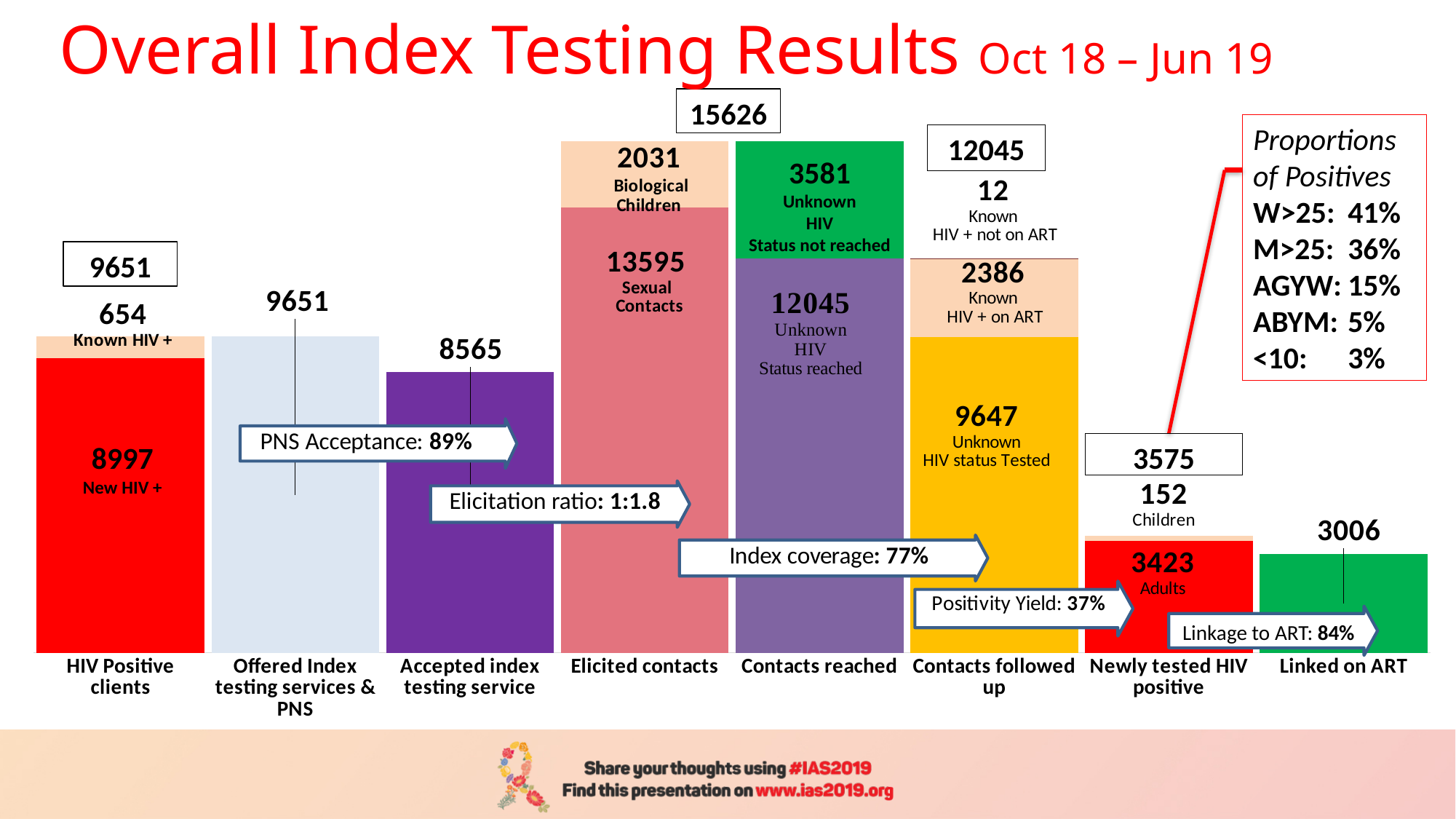
How many contacts followed up are Known HIV + on ART? 2386 In the Newly tested HIV positive bar, which is larger: Adults or Children? Adults How many categories are shown along the x axis? 8 What kind of chart is shown on the slide? bar chart Which category has the lowest bar? Linked on ART What PNS Acceptance percentage is shown on the chart? 89% What is the value for Accepted index testing service? 8565 How many New HIV + clients are shown in the HIV Positive clients bar? 8997 What is the value for Linked on ART? 3006 What is the total of the Elicited contacts stacked bar? 15626 How many Sexual Contacts are shown in the Elicited contacts bar? 13595 What is the difference between Offered Index testing services & PNS and Accepted index testing service? 1086